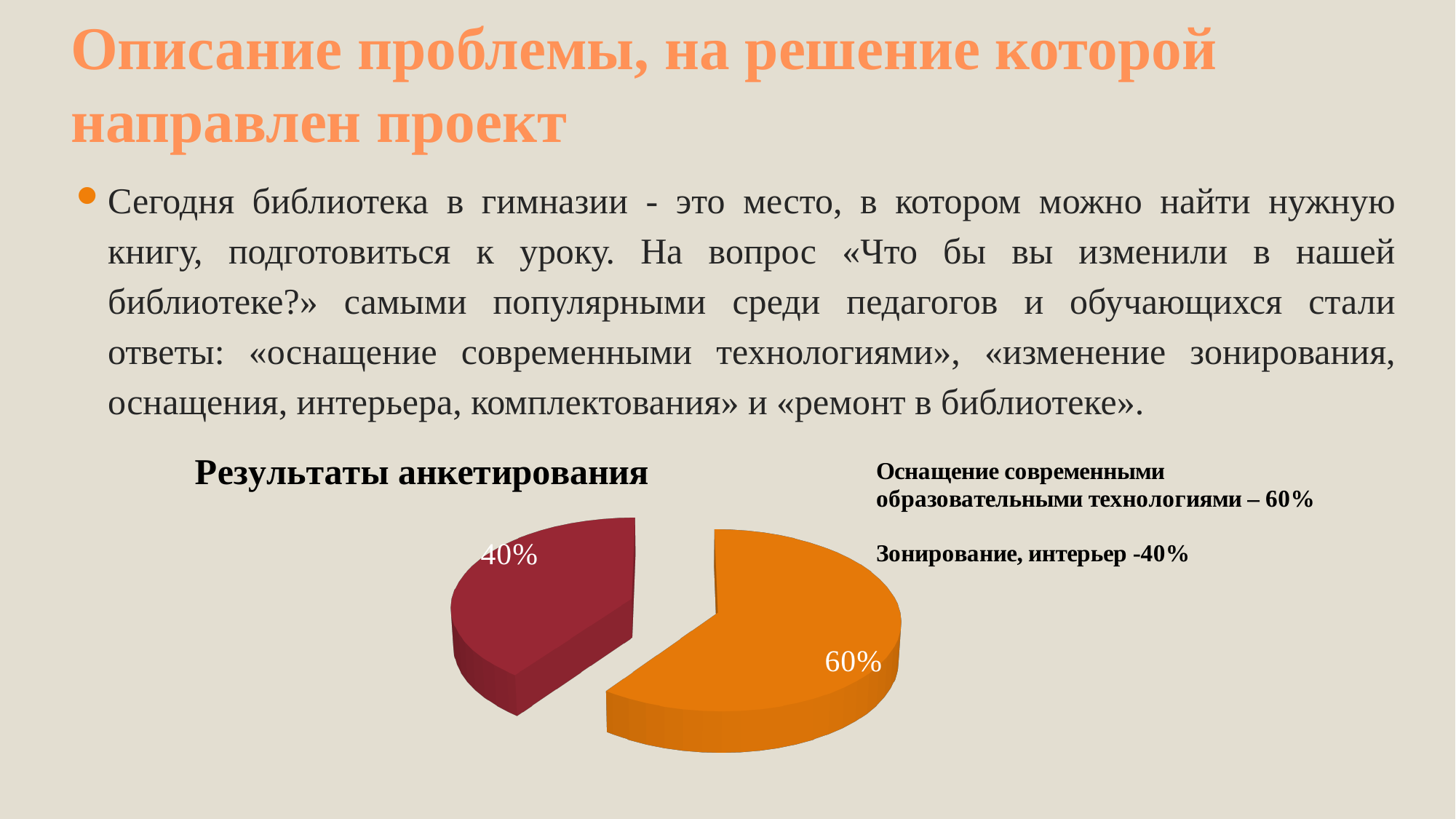
What share of the pie is labelled for «Зонирование, интерьер»? 40% What colour is the 60% slice of the pie? orange What is the title of the chart? Результаты анкетирования What kind of chart is shown on the slide? pie chart What is the difference in percentage points between the 60% slice and the 40% slice? 20% Which is larger: the slice for «Оснащение современными образовательными технологиями» or the slice for «Зонирование, интерьер»? Оснащение современными образовательными технологиями Which category has the largest slice of the pie? Оснащение современными образовательными технологиями What is the value printed on the orange slice? 60% What share of the pie is labelled for «Оснащение современными образовательными технологиями»? 60% What is the value printed on the dark red slice? 40% How many slices does the pie chart have? 2 Which category has the smallest slice of the pie? Зонирование, интерьер